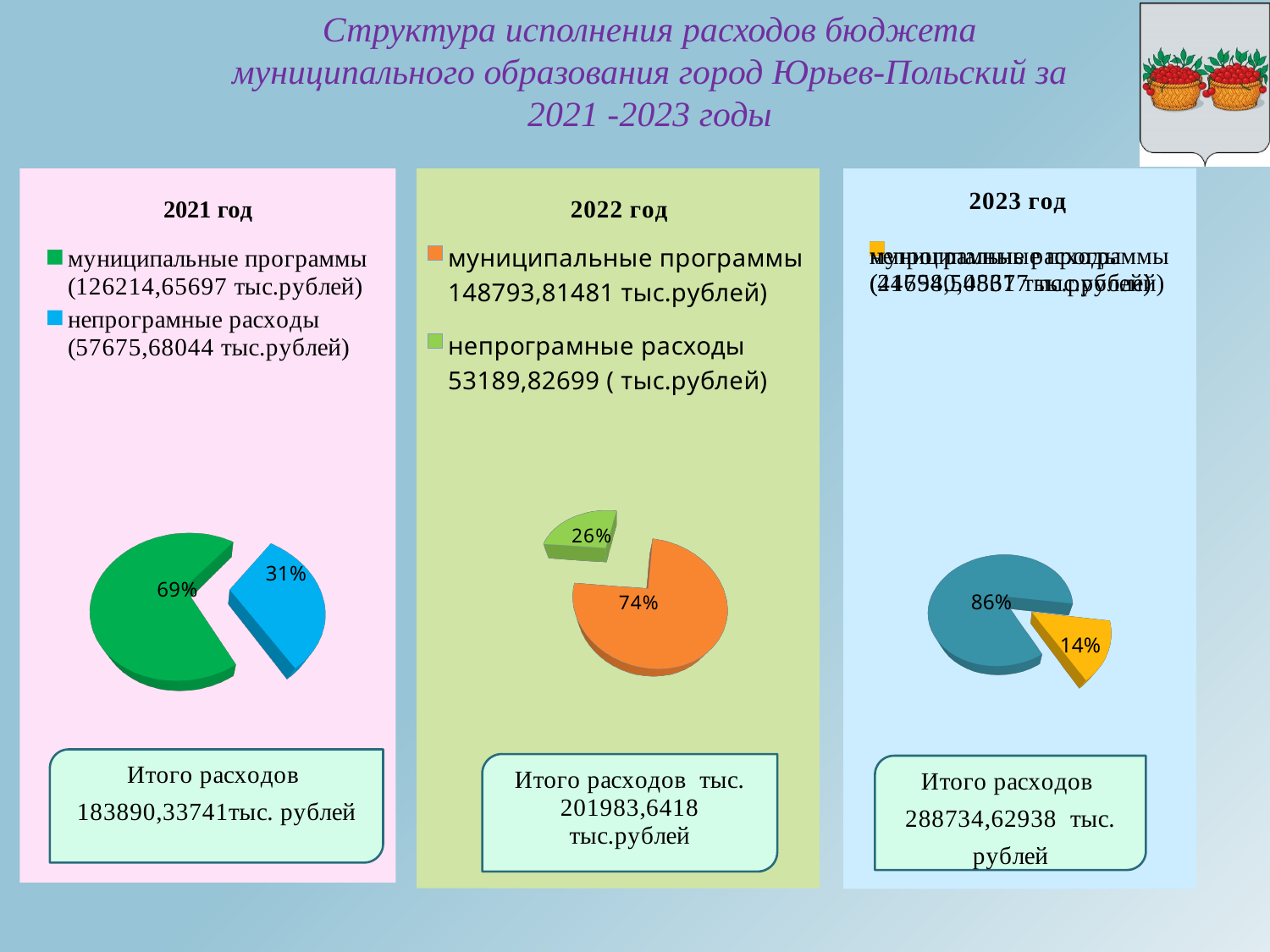
In the 2021 pie chart, what share of expenses is shown for муниципальные программы? 69% In the 2022 pie chart, what is the difference in percentage points between the two slices? 48 percentage points How many slices does the 2021 pie chart have? 2 In the 2022 pie chart, what share of expenses is shown for муниципальные программы? 74% In the 2021 pie chart, what is the difference in percentage points between the муниципальные программы slice and the непрограмные расходы slice? 38 percentage points In the 2022 pie chart, what share of expenses is shown for непрограмные расходы? 26% What type of chart is used for the 2022 year on the slide? pie chart In the 2023 pie chart, what is the share of the largest slice? 86% In the 2021 pie chart, which slice is larger: муниципальные программы or непрограмные расходы? муниципальные программы In the 2023 pie chart, what is the share of the smallest slice? 14% In the 2021 chart, what colour represents муниципальные программы? green